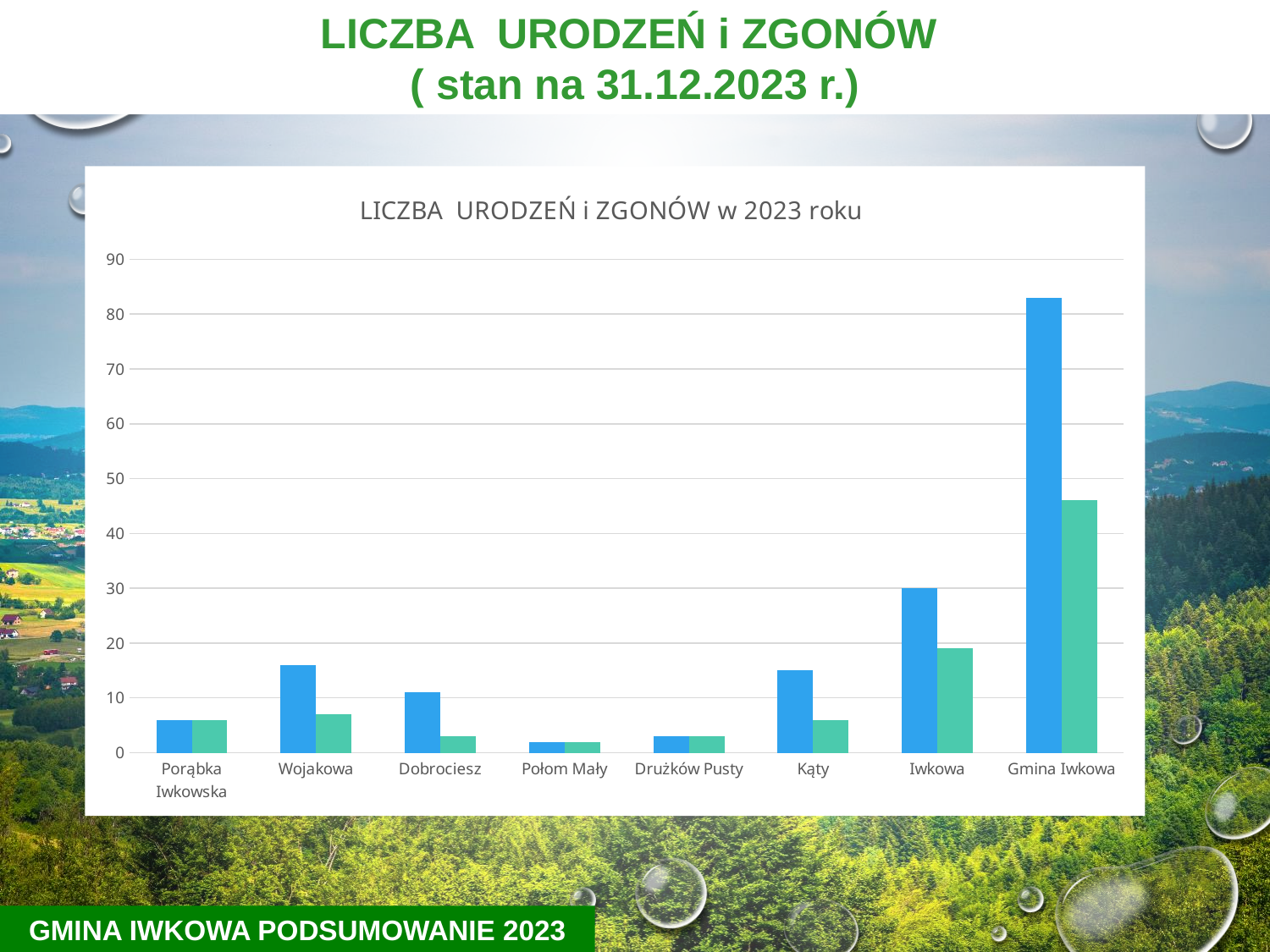
Is the green bar for Iwkowa greater or less than 10? greater Is the green bar for Gmina Iwkowa greater or less than 50? less Which category has the tallest blue bar? Gmina Iwkowa Is the blue bar for Wojakowa greater or less than 10? greater How many categories are shown on the x axis of the chart? 8 Which has the taller blue bar, Iwkowa or Gmina Iwkowa? Gmina Iwkowa For Kąty, which bar is taller, the blue one or the green one? the blue one What kind of chart is shown on the slide? bar chart What is the title of the chart? LICZBA URODZEŃ i ZGONÓW w 2023 roku Which has the taller blue bar, Wojakowa or Dobrociesz? Wojakowa